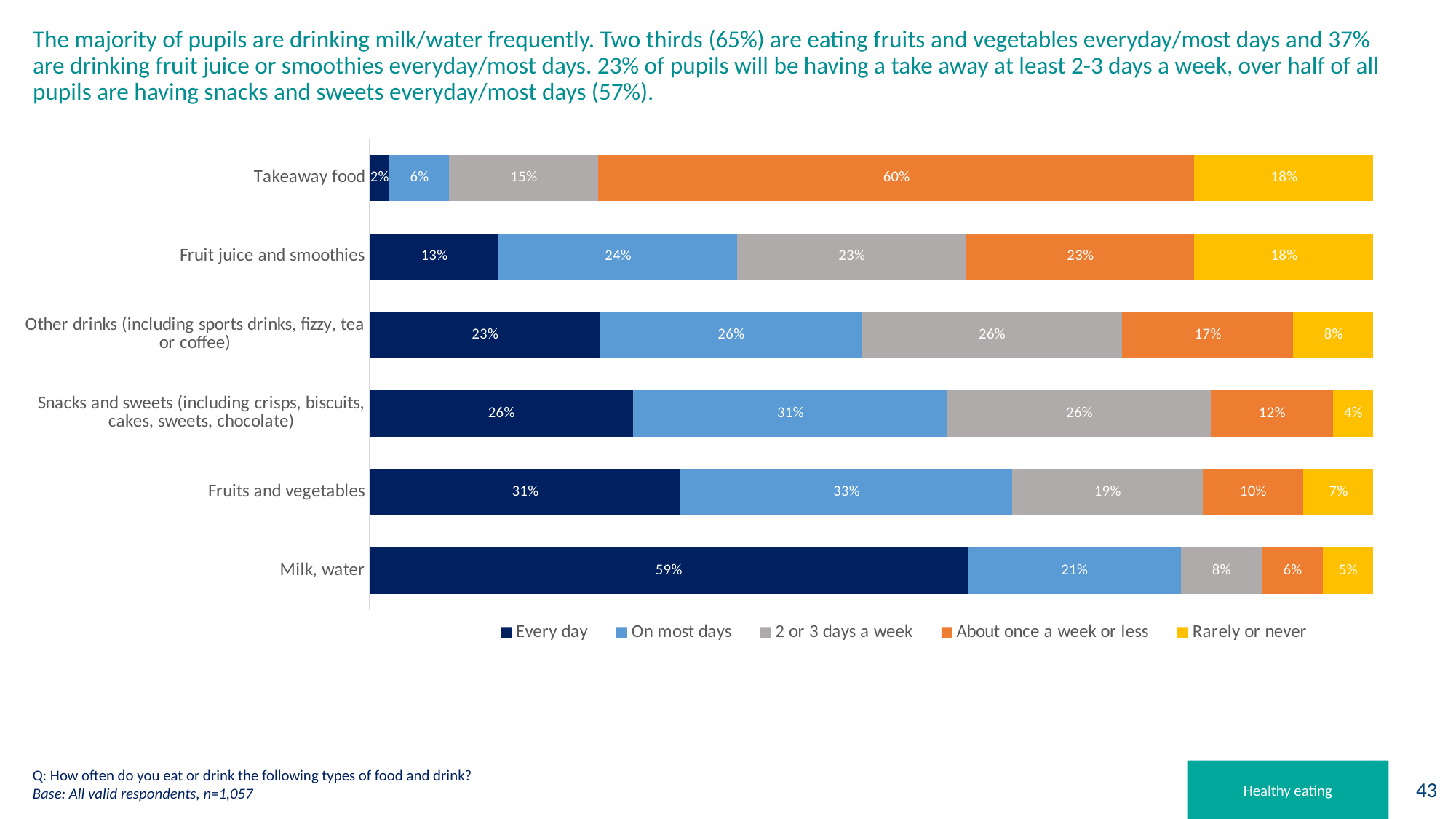
Which food or drink category has the lowest 'Every day' percentage? Takeaway food What is the difference between the 'Every day' percentage for fruits and vegetables and for other drinks? 8% How many food and drink categories are shown in the chart? 6 Which food or drink category has the highest 'Every day' percentage? Milk, water What is the combined percentage of pupils eating fruits and vegetables every day or on most days? 64% What kind of chart is shown on the slide? Stacked bar chart What percentage of pupils eat takeaway food about once a week or less? 60% What percentage of pupils eat snacks and sweets on most days? 31% Which is larger: the 'On most days' percentage for fruits and vegetables or for fruit juice and smoothies? Fruits and vegetables What percentage of pupils drink milk or water every day? 59% How many series does the legend list? 5 What percentage of pupils rarely or never drink fruit juice and smoothies? 18%